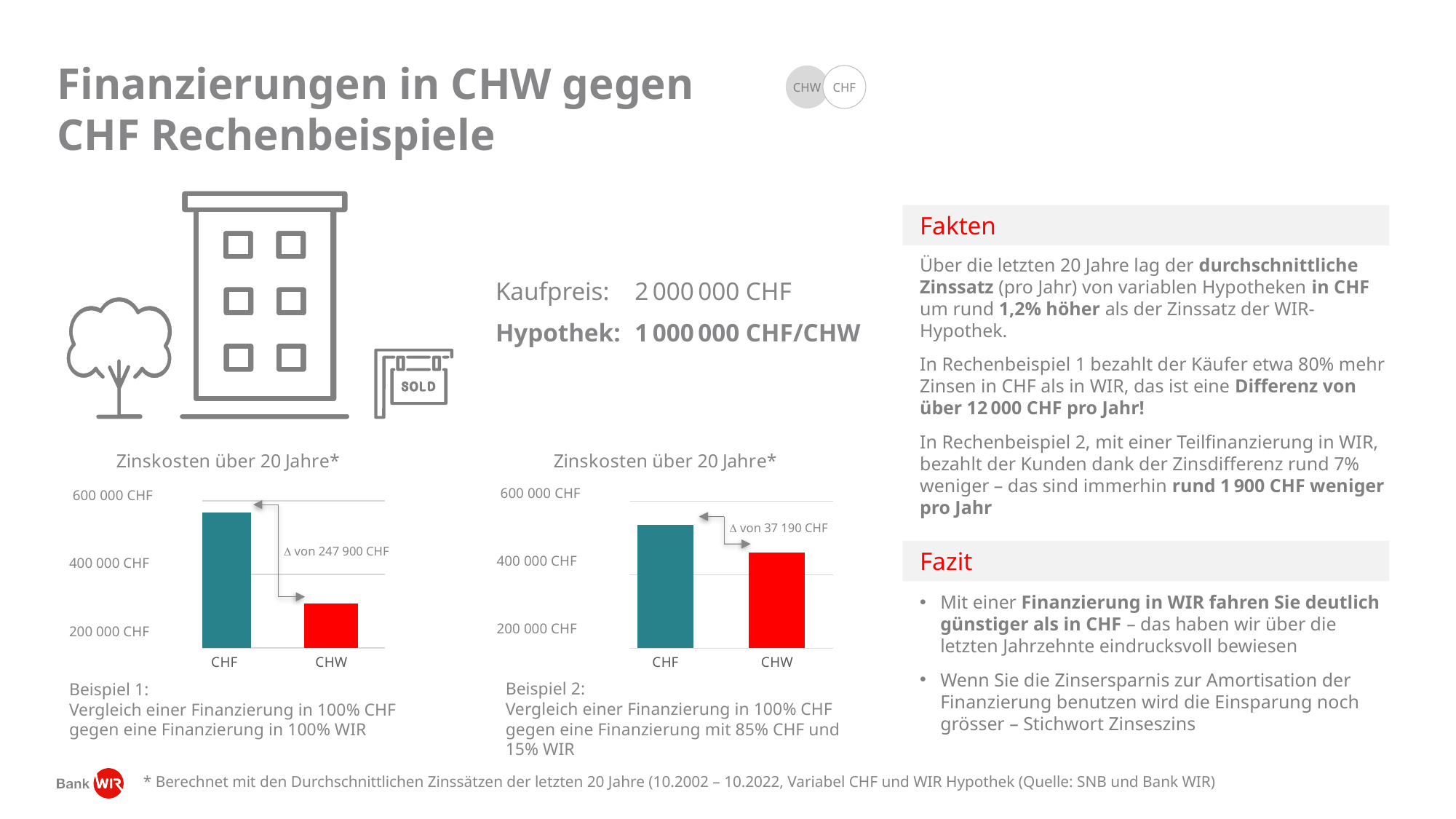
What kind of chart is the left chart titled 'Zinskosten über 20 Jahre*' (Beispiel 1)? bar chart In the left chart (Beispiel 1), which category has the higher interest cost, CHF or CHW? CHF What difference between CHF and CHW is annotated on the right chart (Beispiel 2)? Δ von 37 190 CHF In the left chart (Beispiel 1), what colour is the CHW bar? red In the left chart (Beispiel 1), is the value for CHW greater or less than 400 000 CHF? less In the left chart (Beispiel 1), is the value for CHF greater or less than 400 000 CHF? greater In the right chart (Beispiel 2), is the value for CHW greater or less than 400 000 CHF? greater What is the title of the right chart (Beispiel 2)? Zinskosten über 20 Jahre* How many categories are shown on the x axis of the left chart (Beispiel 1)? 2 What difference between CHF and CHW is annotated on the left chart (Beispiel 1)? Δ von 247 900 CHF In the right chart (Beispiel 2), which category has the highest bar? CHF In the left chart (Beispiel 1), which category has the lowest bar? CHW